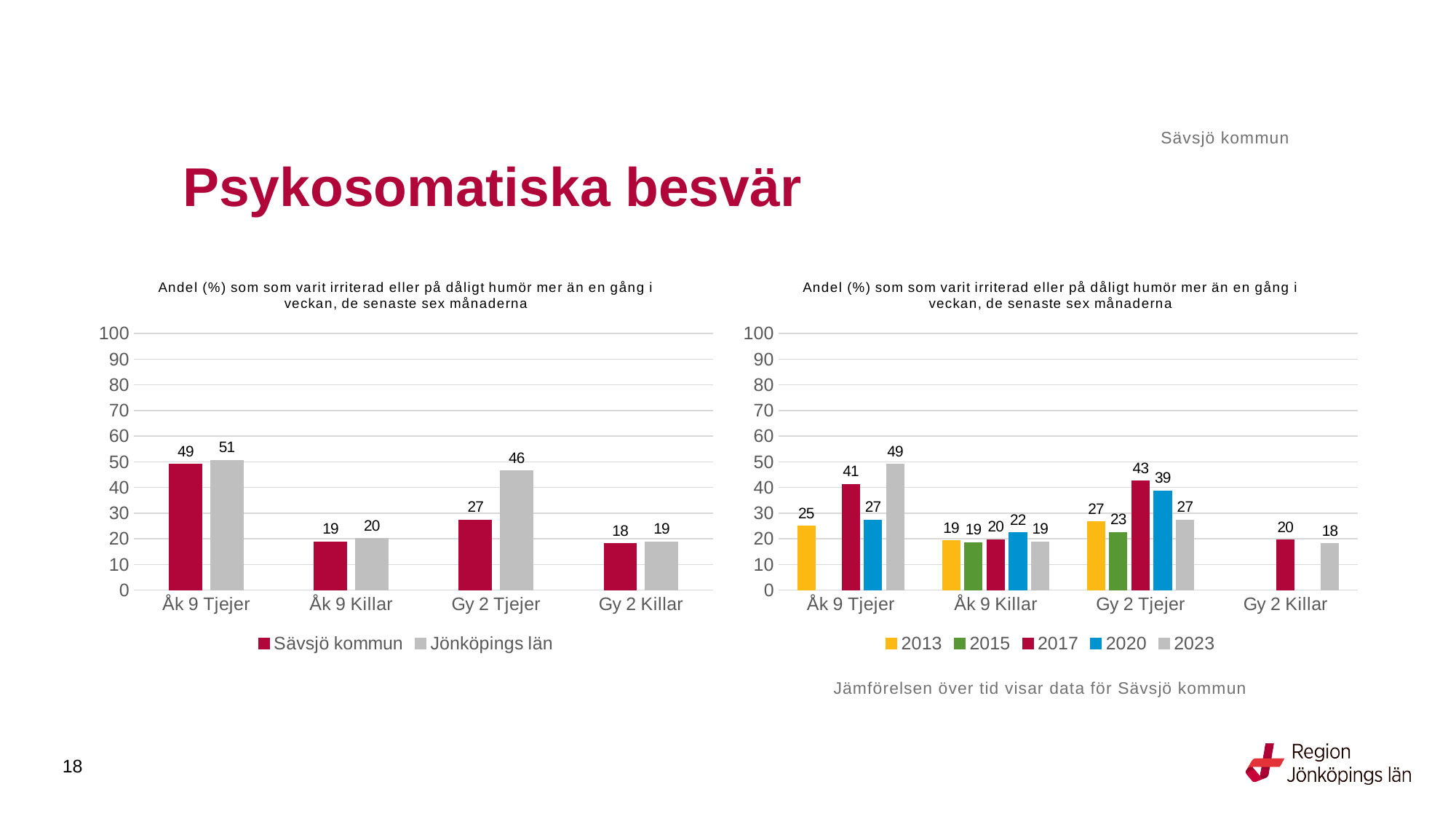
In the left chart, how many series does the legend list? 2 In the left chart, which category has the lowest value for Sävsjö kommun? Gy 2 Killar In the left chart, what is the value for Sävsjö kommun for Åk 9 Tjejer? 49 In the right chart, what is the difference between the 2023 and 2013 values for Åk 9 Tjejer? 24 In the left chart, what is the difference between Jönköpings län and Sävsjö kommun for Gy 2 Tjejer? 19 In the right chart, how many series does the legend list? 5 In the left chart, what is the value for Jönköpings län for Gy 2 Tjejer? 46 In the right chart, what is the value for 2017 for Åk 9 Tjejer? 41 In the right chart, is the 2017 value for Gy 2 Tjejer larger or smaller than the 2020 value? larger In the right chart, which year has the highest value for Åk 9 Tjejer? 2023 What kind of chart is the left chart? bar chart In the right chart, what is the value for 2020 for Gy 2 Tjejer? 39